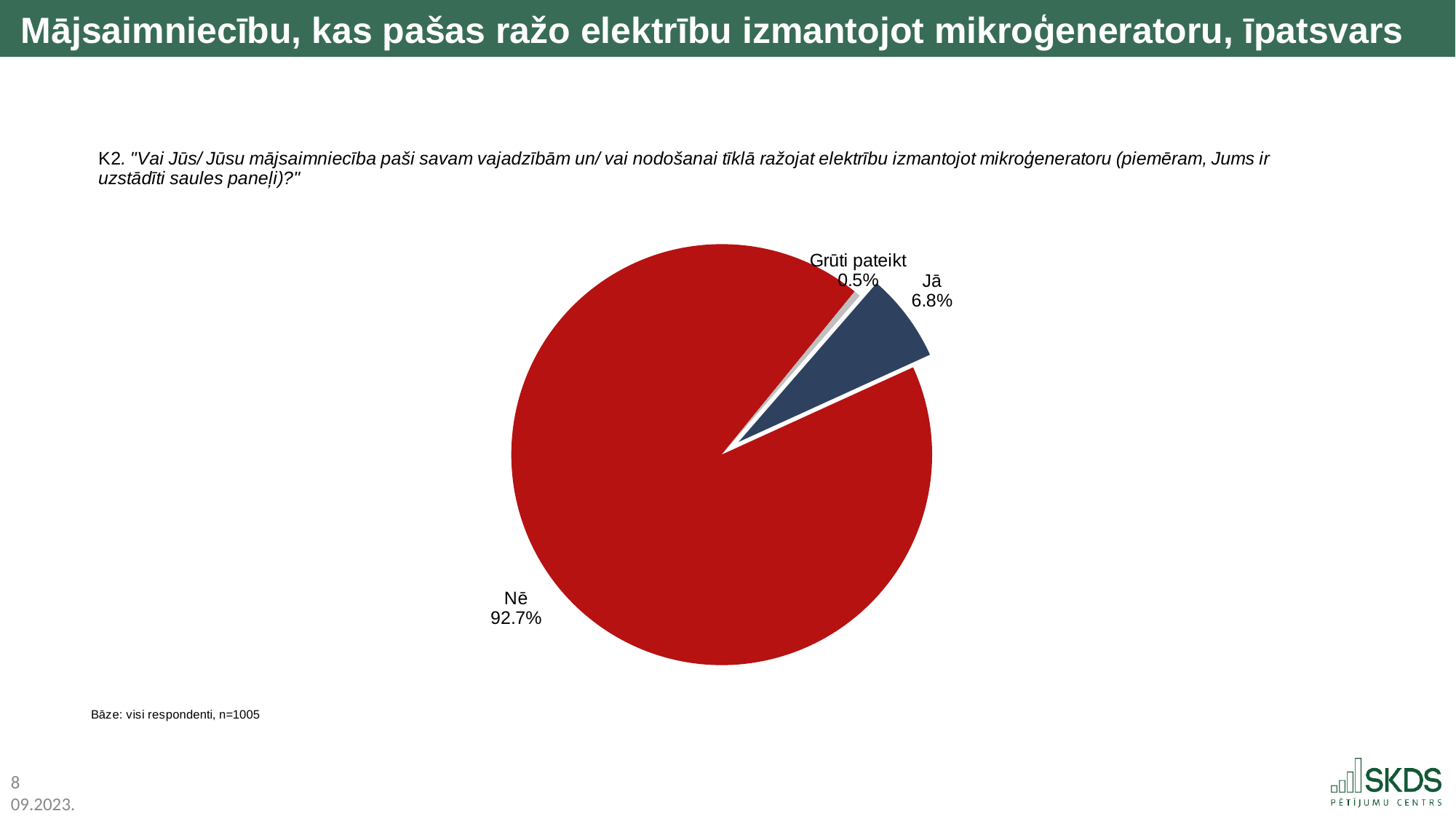
What colour is the "Nē" slice? red What is the difference between the "Nē" and "Jā" values? 85.9% Which is larger, the "Jā" slice or the "Grūti pateikt" slice? Jā What is the base (n) stated below the chart? n=1005 What is the difference between the "Jā" and "Grūti pateikt" values? 6.3% What is the value for the "Nē" slice? 92.7% What is the value for the "Grūti pateikt" slice? 0.5% How many slices does the pie chart have? 3 What is the value for the "Jā" slice? 6.8% Which slice of the pie is the largest? Nē Which slice of the pie is the smallest? Grūti pateikt What kind of chart is shown on the slide? pie chart